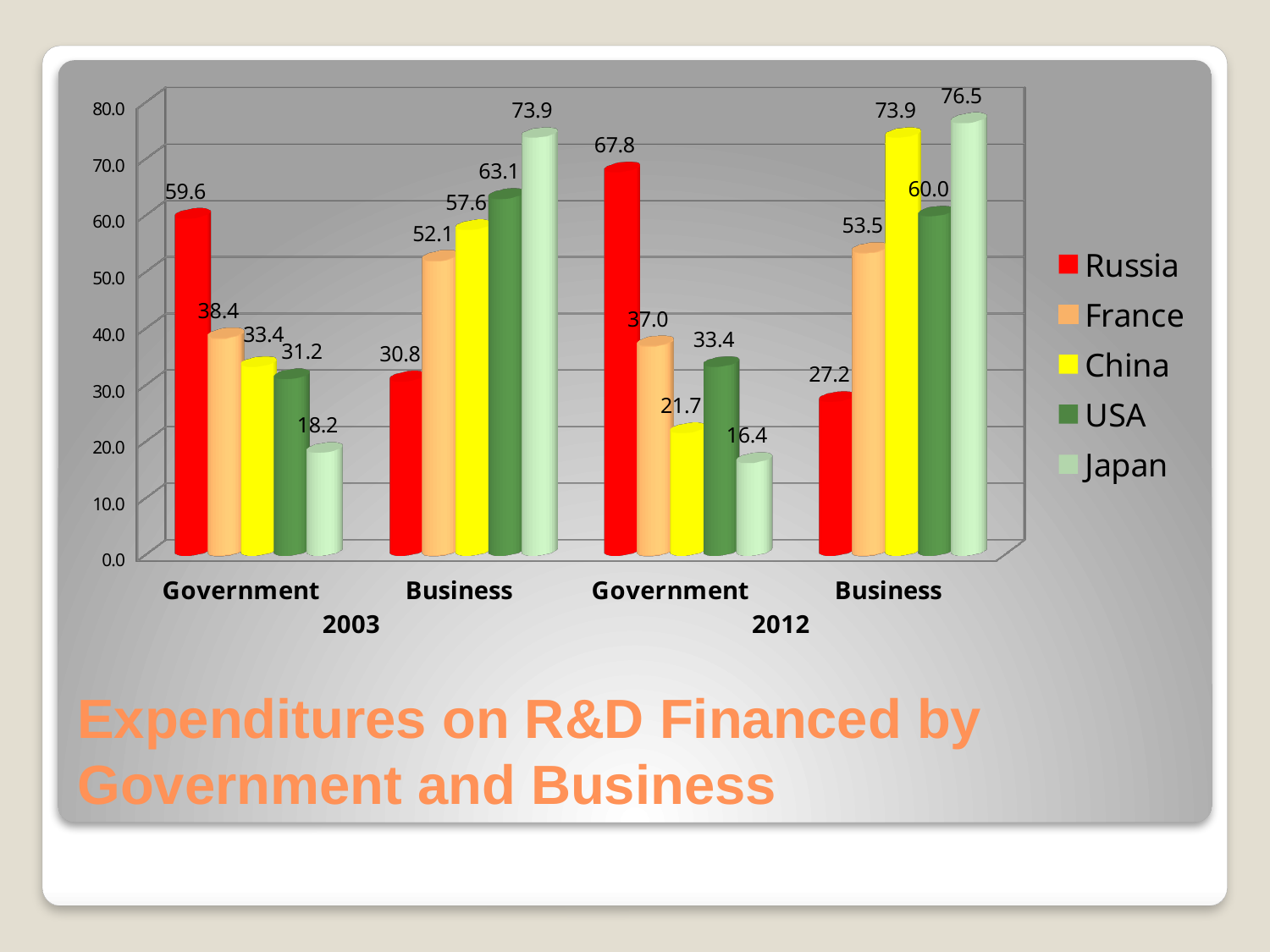
How many series does the legend list? 5 What is the value for Japan in the Business 2012 group? 76.5 What is the difference between Russia's Government value in 2012 and in 2003? 8.2 What kind of chart is shown on the slide? Bar chart What is the value for Russia in the Government 2003 group? 59.6 What is the value for China in the Government 2012 group? 21.7 Which is larger: USA's Business value in 2003 or in 2012? 2003 How many category groups are shown on the x axis? 4 What colour represents China in the chart? Yellow Which country has the lowest value in the Government 2012 group? Japan Which country has the highest value in the Business 2003 group? Japan What is the title of the chart? Expenditures on R&D Financed by Government and Business